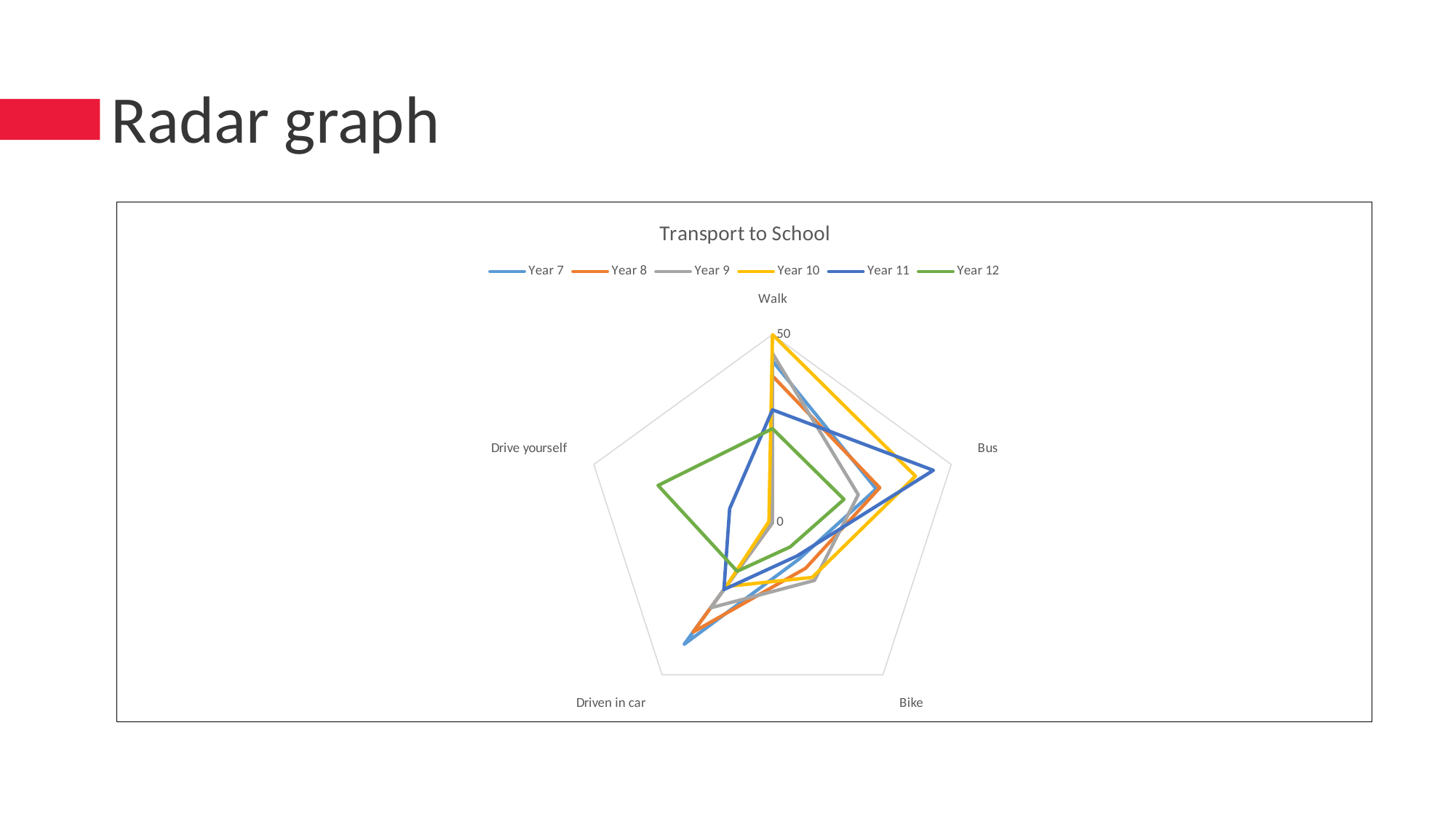
Which year group has the highest value for Walk? Year 10 Which year group has the lowest value for Walk? Year 12 What is the title of the chart? Transport to School How many categories (axes) does the radar chart have? 5 Which series is drawn in green in the legend? Year 12 How many series does the legend list? 6 Is the value for Year 12 on the Walk axis greater or less than 50? less Which is larger: Year 12's value for Drive yourself or Year 10's value for Drive yourself? Year 12 What kind of chart is shown on the slide? Radar chart Which year group has the highest value for Bus? Year 11 Which year group has the lowest value for Bus? Year 12 Which year group has the highest value for Drive yourself? Year 12